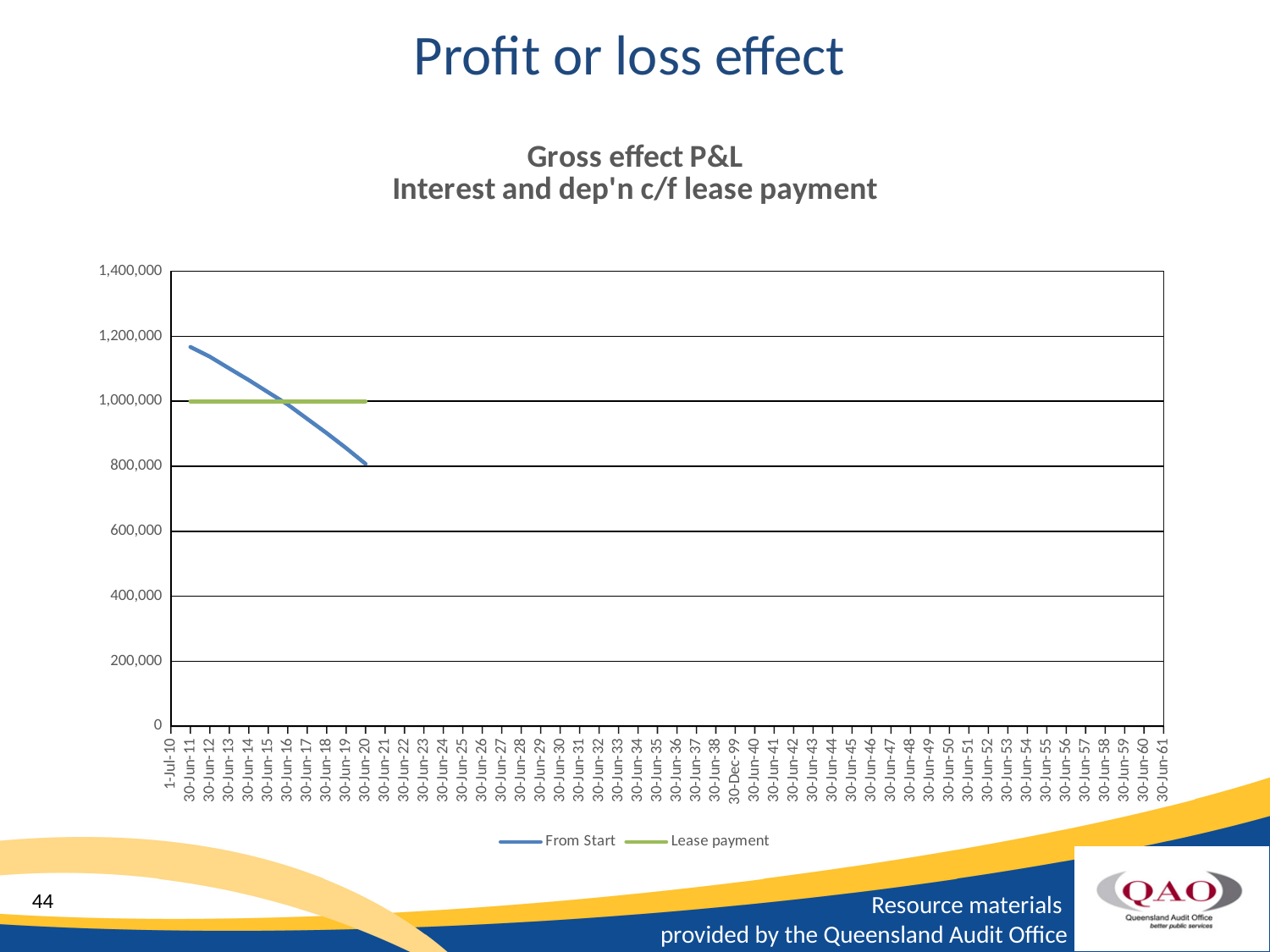
What is the title of the chart? Gross effect P&L Interest and dep'n c/f lease payment Does the Lease payment series rise, fall or stay flat from 30-Jun-11 to 30-Jun-20? stay flat How many series does the legend list? 2 Is the value of From Start at 30-Jun-11 greater or less than 1,000,000? greater Which series reaches the highest value on the chart? From Start Is the value of From Start at 30-Jun-20 greater or less than 1,000,000? less Does the From Start series rise or fall from 30-Jun-11 to 30-Jun-20? fall Is the value of Lease payment at 30-Jun-15 greater or less than 1,200,000? less At 30-Jun-19, which series has the larger value, From Start or Lease payment? Lease payment At 30-Jun-12, which series has the larger value, From Start or Lease payment? From Start What are the two series named in the legend? From Start and Lease payment What kind of chart is shown on the slide? line chart